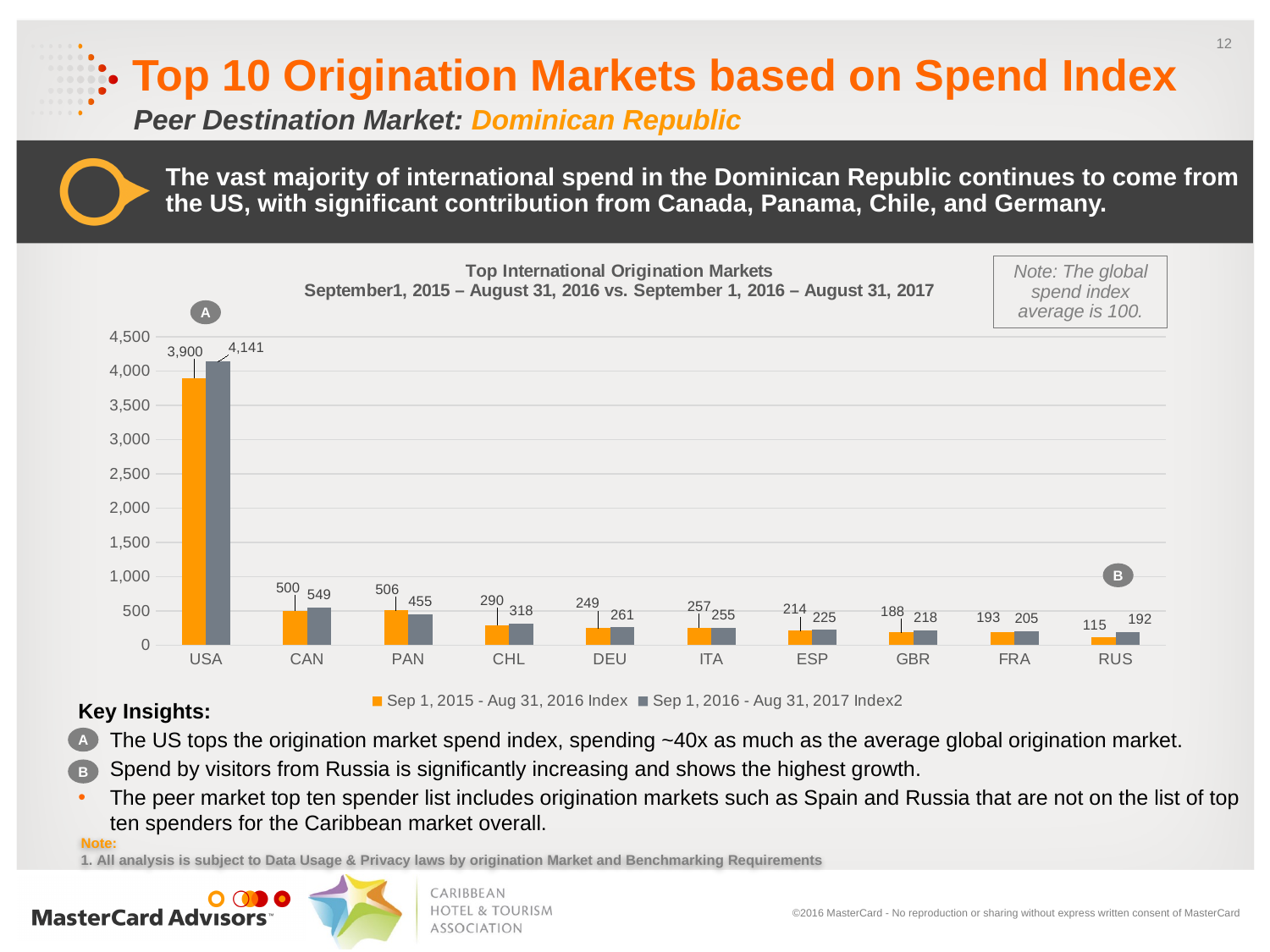
Which origination market has the highest Sep 1, 2016 - Aug 31, 2017 Index2 value? USA How many series does the chart legend list? 2 What is the Sep 1, 2016 - Aug 31, 2017 Index2 value for CAN? 549 Which origination market has the lowest Sep 1, 2015 - Aug 31, 2016 Index value? RUS How many origination markets are shown on the x axis of the chart? 10 Is the Sep 1, 2016 - Aug 31, 2017 Index2 value for CHL greater or less than 500? less For PAN, which is larger: the Sep 1, 2015 - Aug 31, 2016 Index value or the Sep 1, 2016 - Aug 31, 2017 Index2 value? Sep 1, 2015 - Aug 31, 2016 Index What is the title of the chart? Top International Origination Markets September1, 2015 – August 31, 2016 vs. September 1, 2016 – August 31, 2017 What is the Sep 1, 2016 - Aug 31, 2017 Index2 value for RUS? 192 What is the Sep 1, 2015 - Aug 31, 2016 Index value for USA? 3,900 What is the difference between the Sep 1, 2016 - Aug 31, 2017 Index2 value and the Sep 1, 2015 - Aug 31, 2016 Index value for USA? 241 What type of chart is shown on the slide? Bar chart